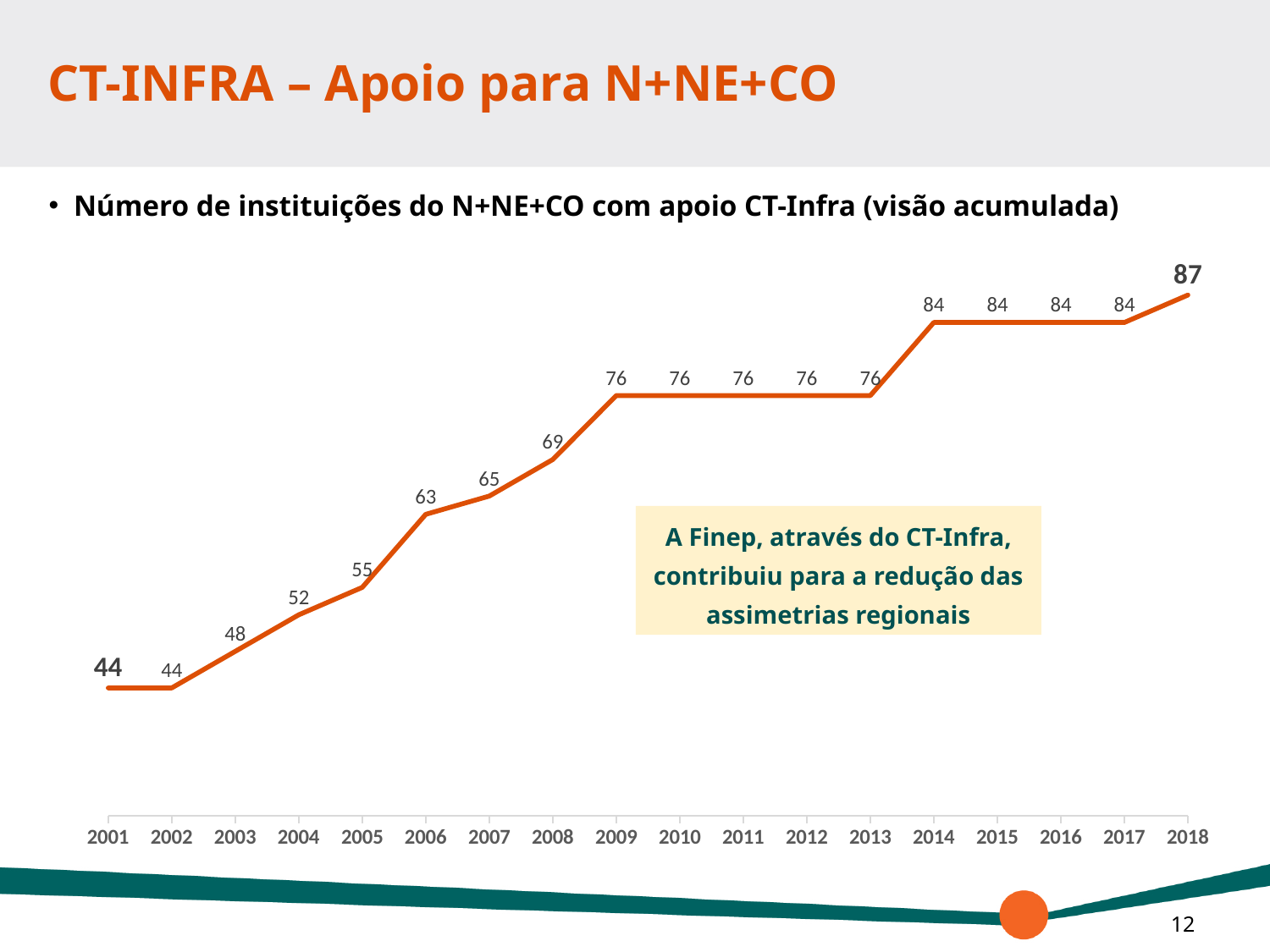
Which year has the highest value? 2018 How many years are shown on the x axis? 18 What colour is the line in the chart? orange Which is larger, the value for 2005 or the value for 2007? 2007 What is the value for 2018? 87 What is the difference between the values for 2009 and 2008? 7 What is the value for 2001? 44 What kind of chart is this? line chart Do the values rise or fall from 2001 to 2018? rise What is the value for 2014? 84 What is the difference between the values for 2018 and 2001? 43 What is the value for 2006? 63